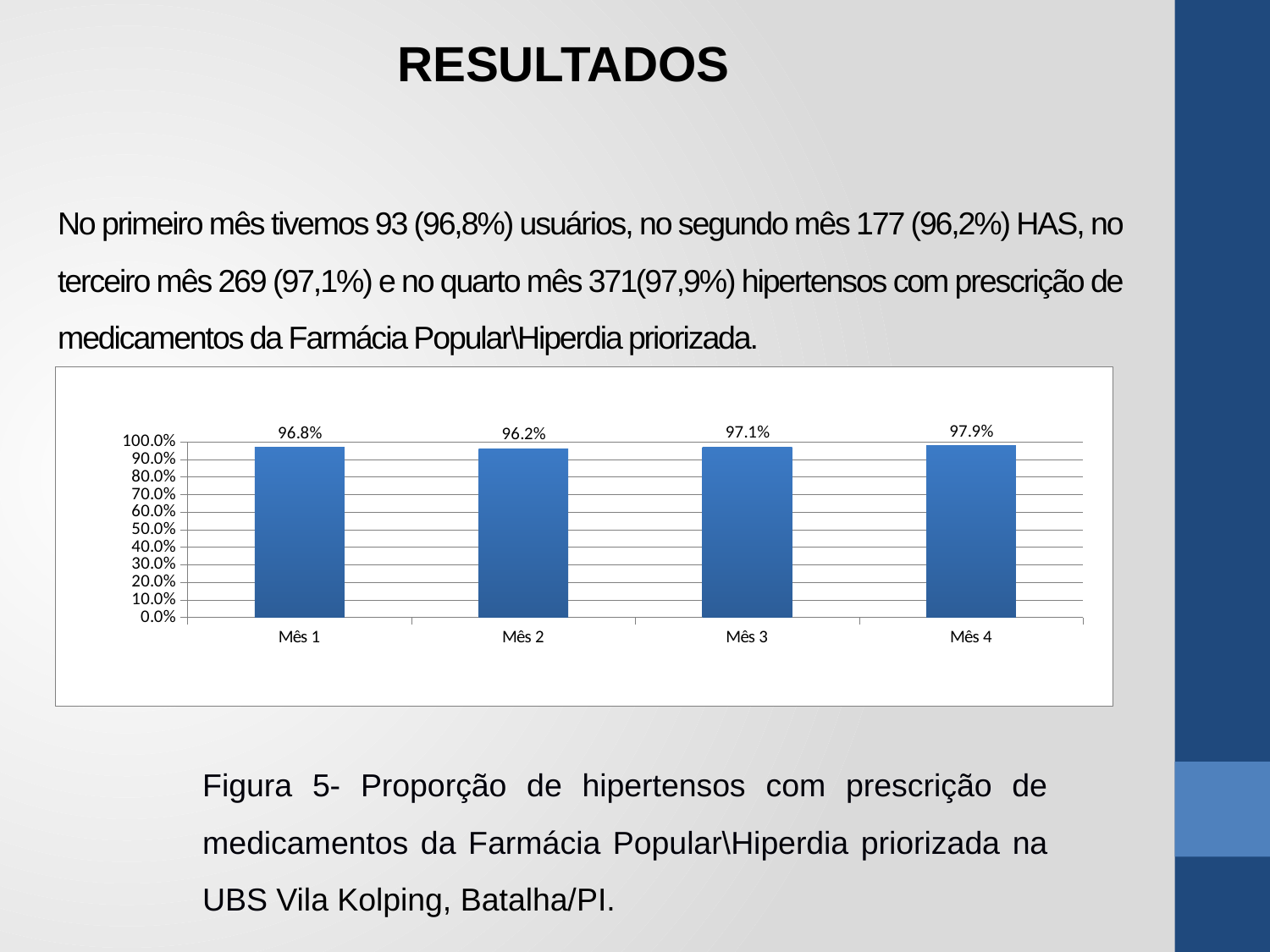
What is the difference between the values for Mês 4 and Mês 2? 1.7% What is the value for Mês 3? 97.1% How many months are shown on the x axis of the chart? 4 What is the value for Mês 4? 97.9% What is the highest tick value shown on the y axis of the chart? 100.0% What kind of chart is shown on the slide? Bar chart What is the value for Mês 2? 96.2% Which month has the lowest value? Mês 2 Which is larger, the value for Mês 1 or the value for Mês 2? Mês 1 What is the difference between the values for Mês 3 and Mês 1? 0.3% What is the value for Mês 1? 96.8% Which month has the highest value? Mês 4